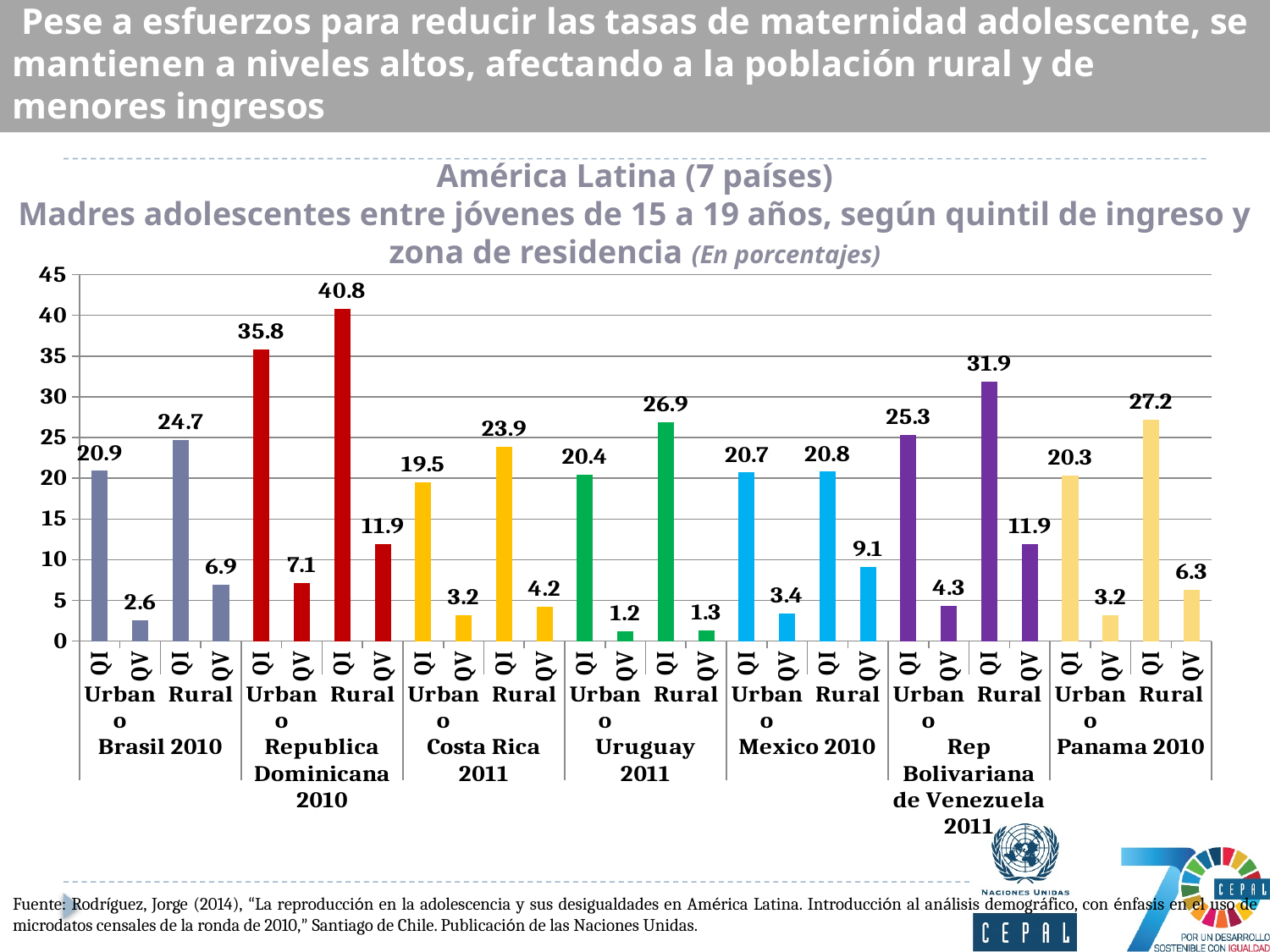
What is the value for Urbano QV in Uruguay 2011? 1.2 What is the difference between Rural QI and Rural QV in Rep Bolivariana de Venezuela 2011? 20.0 Which country and group has the lowest value in the chart? Uruguay 2011, Urbano QV (1.2) Which is larger: Rural QI in Panama 2010 or Rural QI in Uruguay 2011? Rural QI in Panama 2010 (27.2) What type of chart is shown on the slide? bar chart What is the value for Rural QV in Mexico 2010? 9.1 Is the value for Urbano QI in Costa Rica 2011 greater or less than 20? less How many countries are shown in the chart? 7 Which country and group has the highest value in the chart? Republica Dominicana 2010, Rural QI (40.8) What is the value for Rural QI in Republica Dominicana 2010? 40.8 What unit does the chart title say the values are in? En porcentajes What is the difference between Rural QI and Urbano QI in Brasil 2010? 3.8